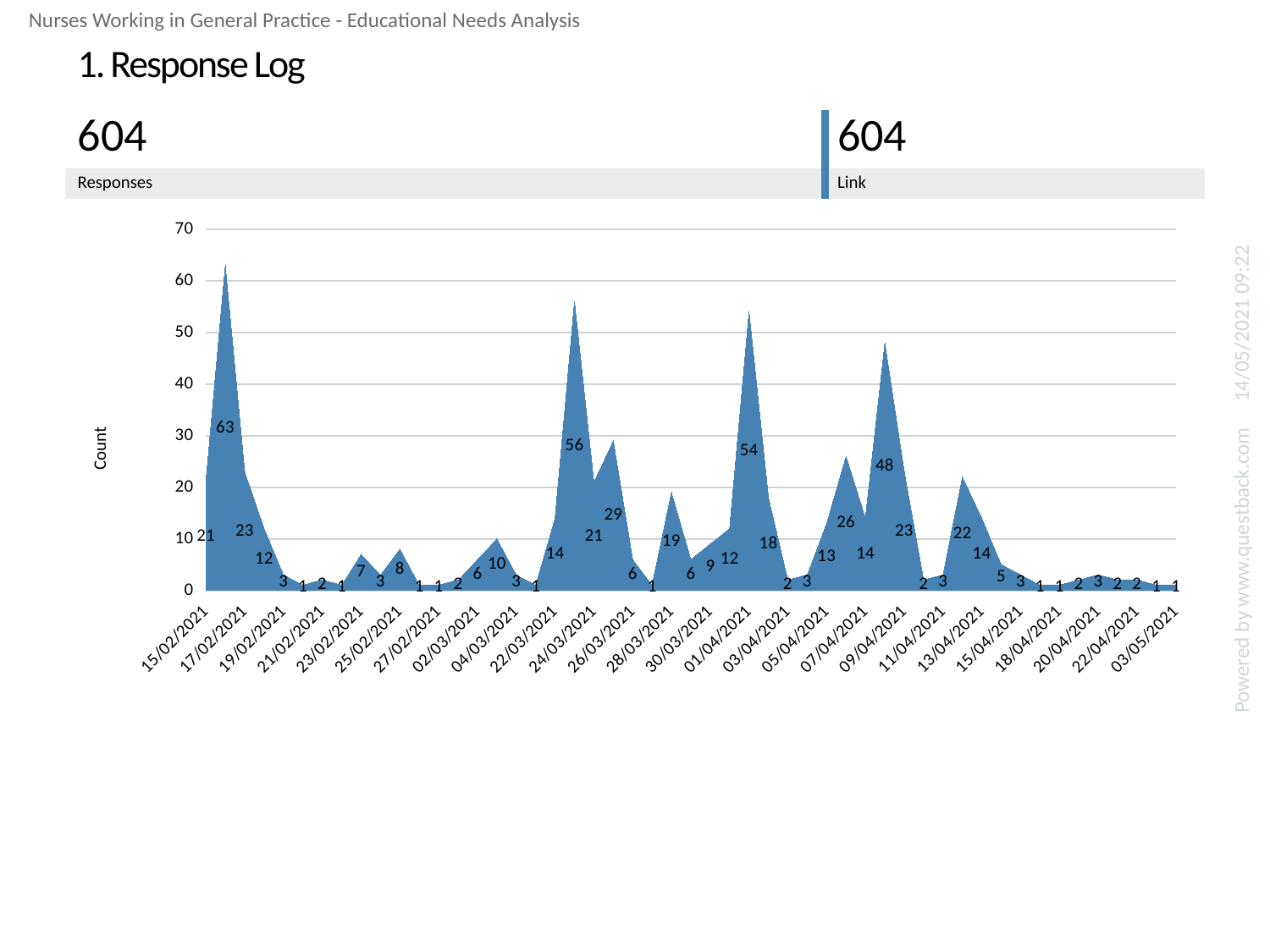
What is the total number of responses shown above the chart? 604 Is the highest peak on the chart greater or less than 60? greater Which peak is larger, the one labelled 56 or the one labelled 54? 56 What is the label on the vertical axis? Count What is the difference between the highest peak (63) and the second-highest peak (56)? 7 Is the peak labelled 48 greater or less than 50? less What is the highest value plotted on the chart? 63 What is the value for 03/05/2021, the last date on the x axis? 1 What type of chart is shown on the slide? area chart What is the value for 15/02/2021? 21 What is the maximum value shown on the vertical axis? 70